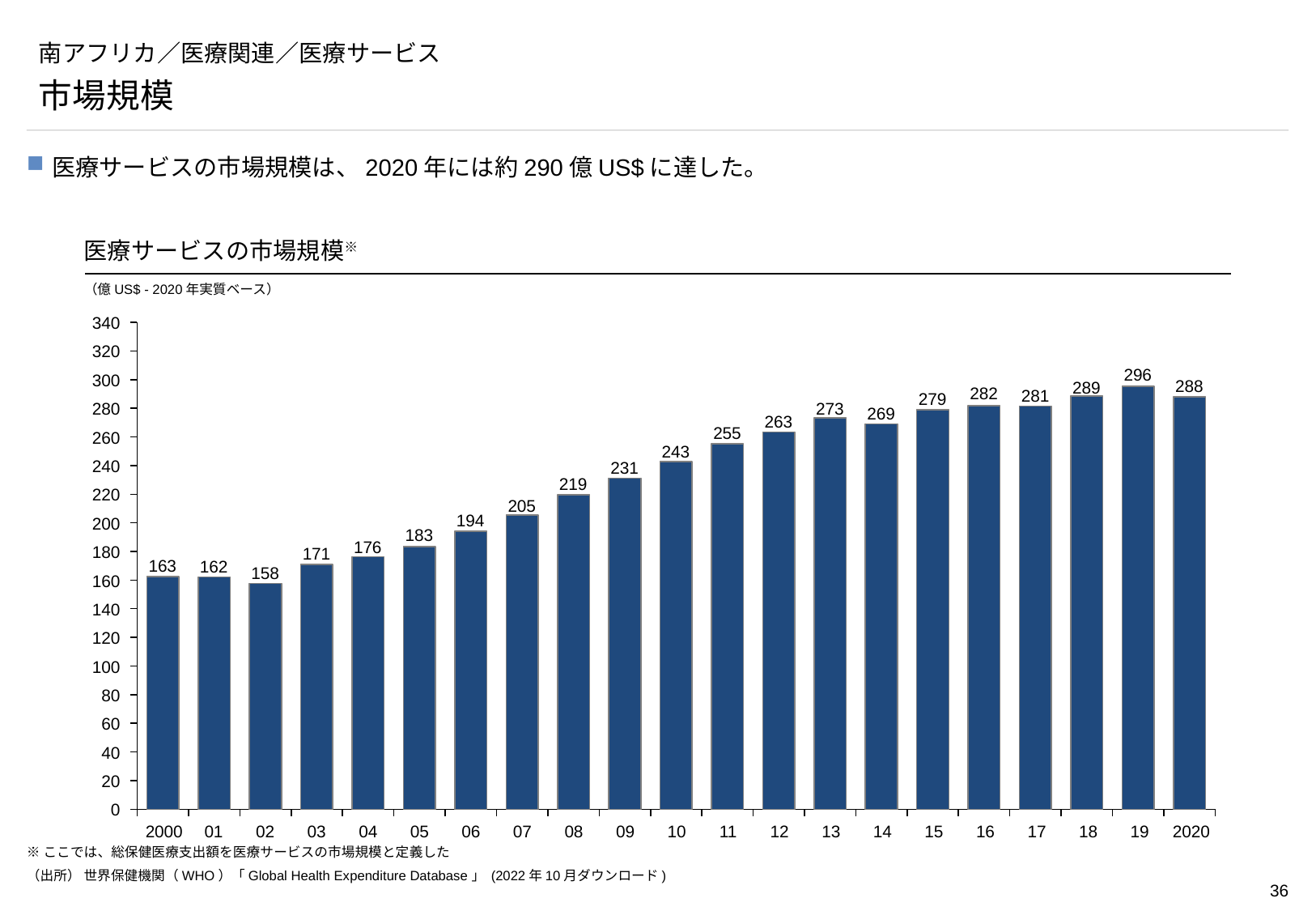
What kind of chart is this? bar chart Do the values generally rise or fall from 2000 to 2020? rise What is the difference between the values for 2020 and 2000? 125 How many years are shown on the x axis? 21 What is the value for 2000? 163 Which is larger, the value for 13 or the value for 14? 13 What is the value for 10 (2010)? 243 What is the difference between the values for 19 and 2020? 8 Which year has the lowest value? 02 What is the value for 2020? 288 Which year has the highest value? 19 Is the value for 11 greater or less than 240? greater